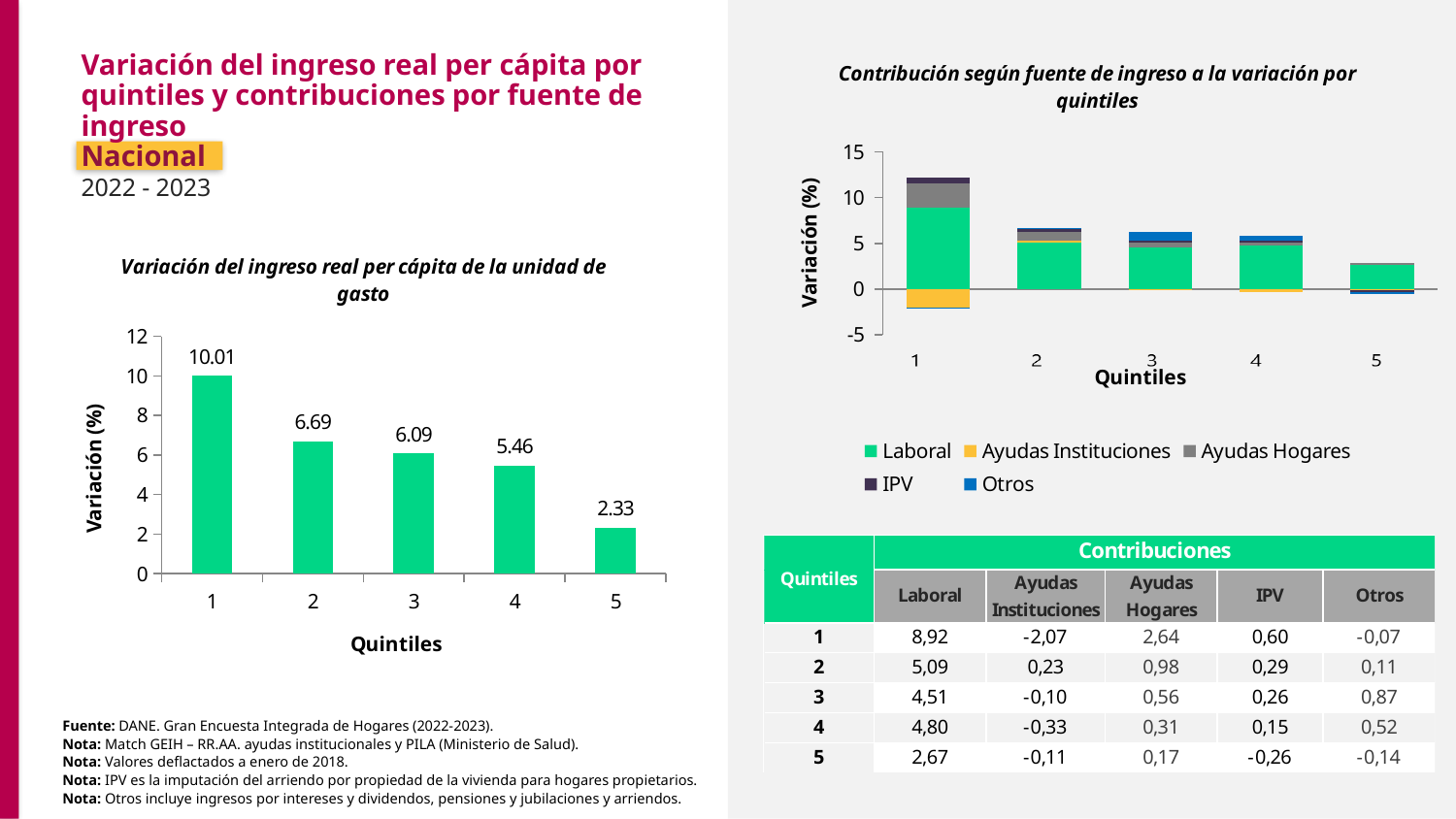
In the chart 'Variación del ingreso real per cápita de la unidad de gasto', which quintile has the highest value? 1 What kind of chart is 'Contribución según fuente de ingreso a la variación por quintiles'? Stacked bar chart How many quintiles are shown in the chart 'Variación del ingreso real per cápita de la unidad de gasto'? 5 In the chart 'Contribución según fuente de ingreso a la variación por quintiles', is the Laboral value for quintile 1 greater or less than 5? greater In the chart 'Variación del ingreso real per cápita de la unidad de gasto', which is larger, the value for quintile 3 or quintile 4? Quintile 3 How many series does the legend of the chart 'Contribución según fuente de ingreso a la variación por quintiles' list? 5 In the chart 'Variación del ingreso real per cápita de la unidad de gasto', what is the value for quintile 1? 10.01 In the chart 'Variación del ingreso real per cápita de la unidad de gasto', do the values rise or fall from quintile 1 to quintile 5? Fall In the chart 'Variación del ingreso real per cápita de la unidad de gasto', which quintile has the lowest value? 5 In the chart 'Contribución según fuente de ingreso a la variación por quintiles', which colour represents the Laboral series? Green In the chart 'Variación del ingreso real per cápita de la unidad de gasto', what is the difference between the values for quintile 2 and quintile 3? 0.60 In the chart 'Variación del ingreso real per cápita de la unidad de gasto', what is the value for quintile 4? 5.46